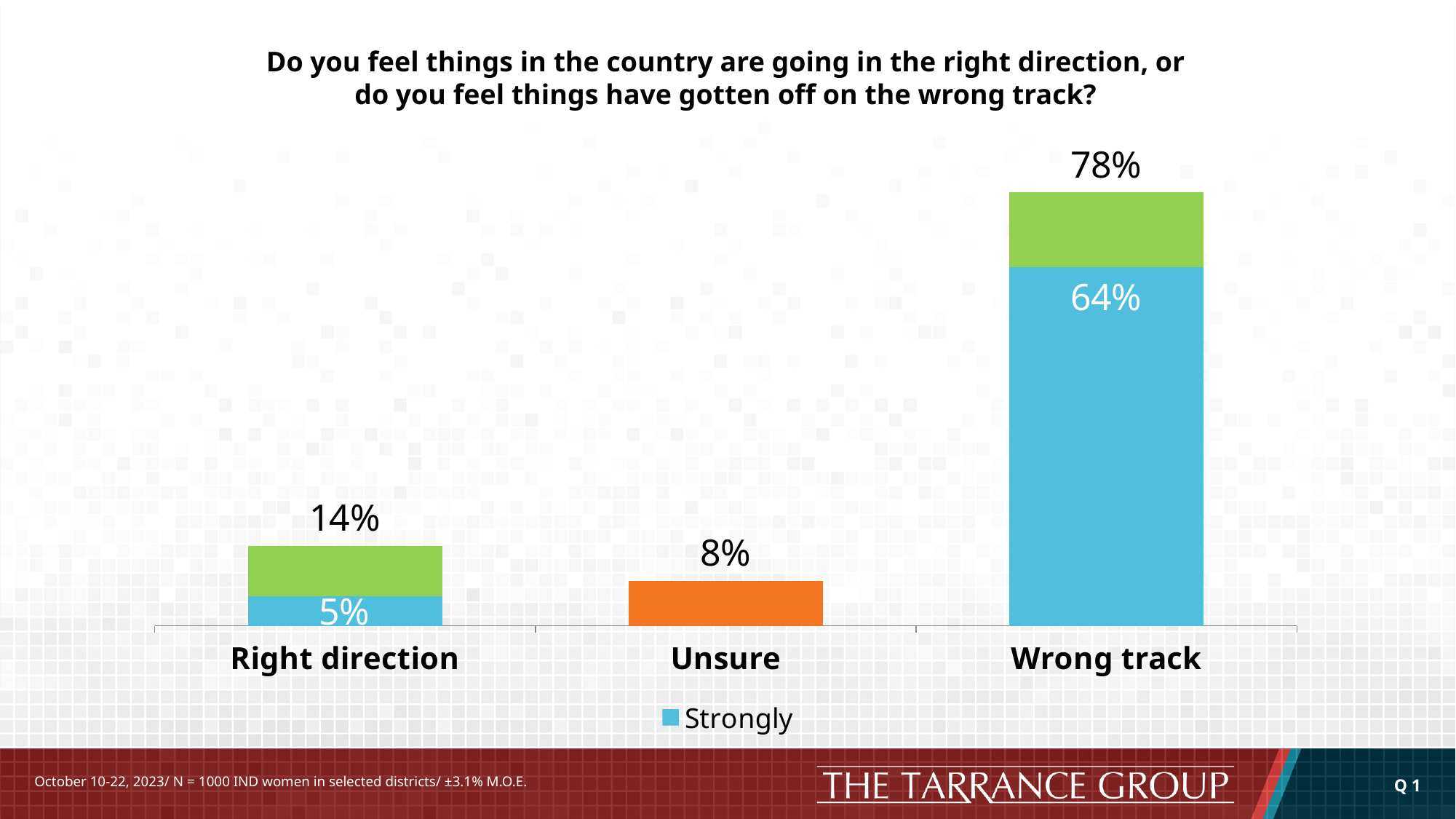
What is the 'Strongly' value for Right direction? 5% What kind of chart is shown on the slide? Bar chart Which category has the lowest value? Unsure What is the only entry listed in the legend? Strongly What is the total value shown for Wrong track? 78% What is the difference between the total for Wrong track and the total for Right direction? 64% What is the total value shown for Right direction? 14% What is the value shown for Unsure? 8% What is the 'Strongly' value for Wrong track? 64% How many categories are shown on the x axis? 3 Which category has the highest total value? Wrong track Which is larger, the total for Right direction or the value for Unsure? Right direction